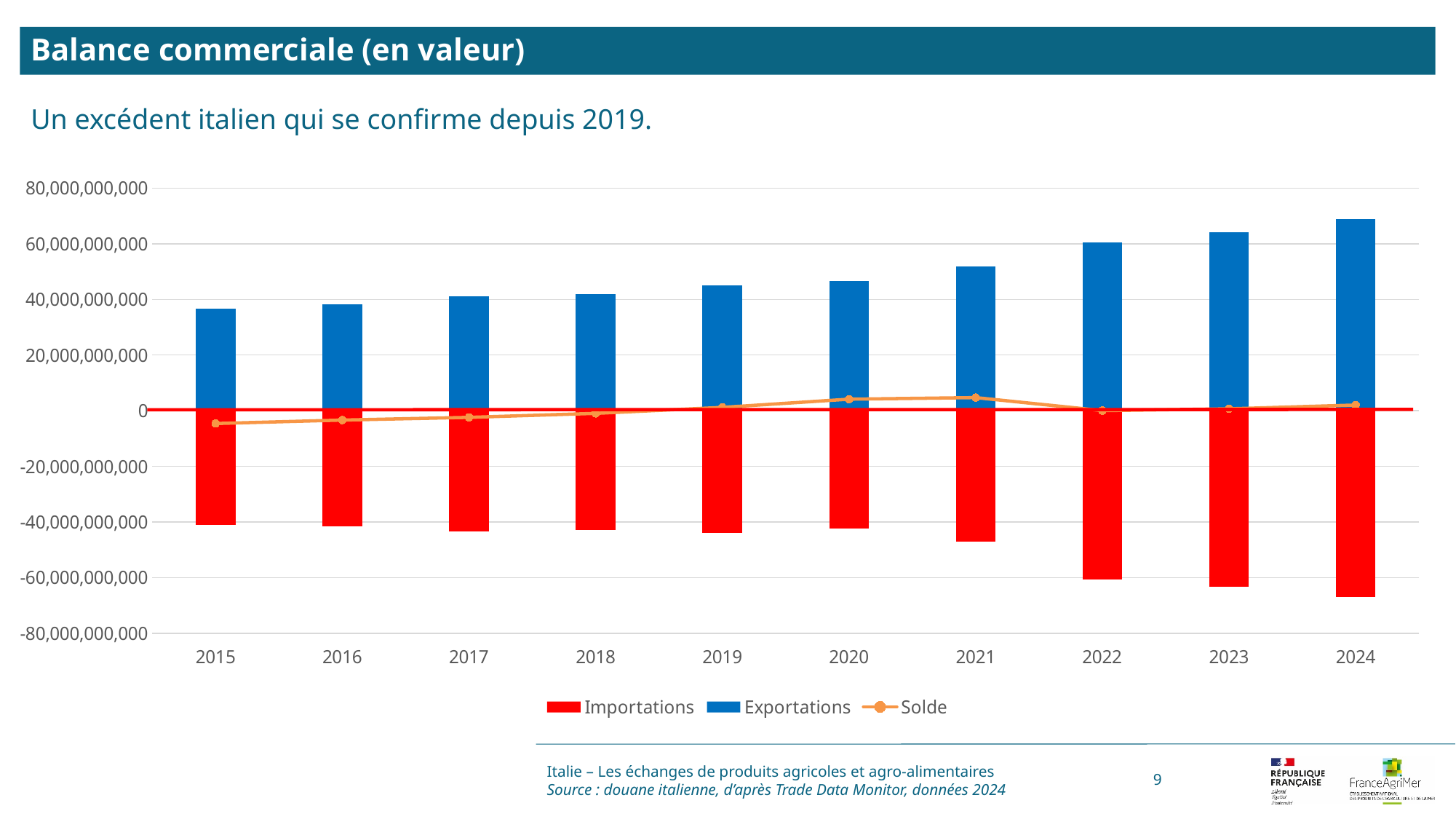
Is the Exportations value for 2015 greater or less than 40,000,000,000? less How many years are shown on the x axis? 10 Which year has the highest Exportations value? 2024 Do the Exportations values rise or fall from 2015 to 2024? rise What kind of chart is shown on the slide? Bar chart with a line series Which year has the lowest Exportations value? 2015 What is the title of the chart slide? Balance commerciale (en valeur) Is the Exportations value for 2021 greater or less than 40,000,000,000? greater How many series does the legend list? 3 Is the Importations value for 2024 greater or less than -60,000,000,000? less Which is larger, the Exportations value for 2023 or for 2019? 2023